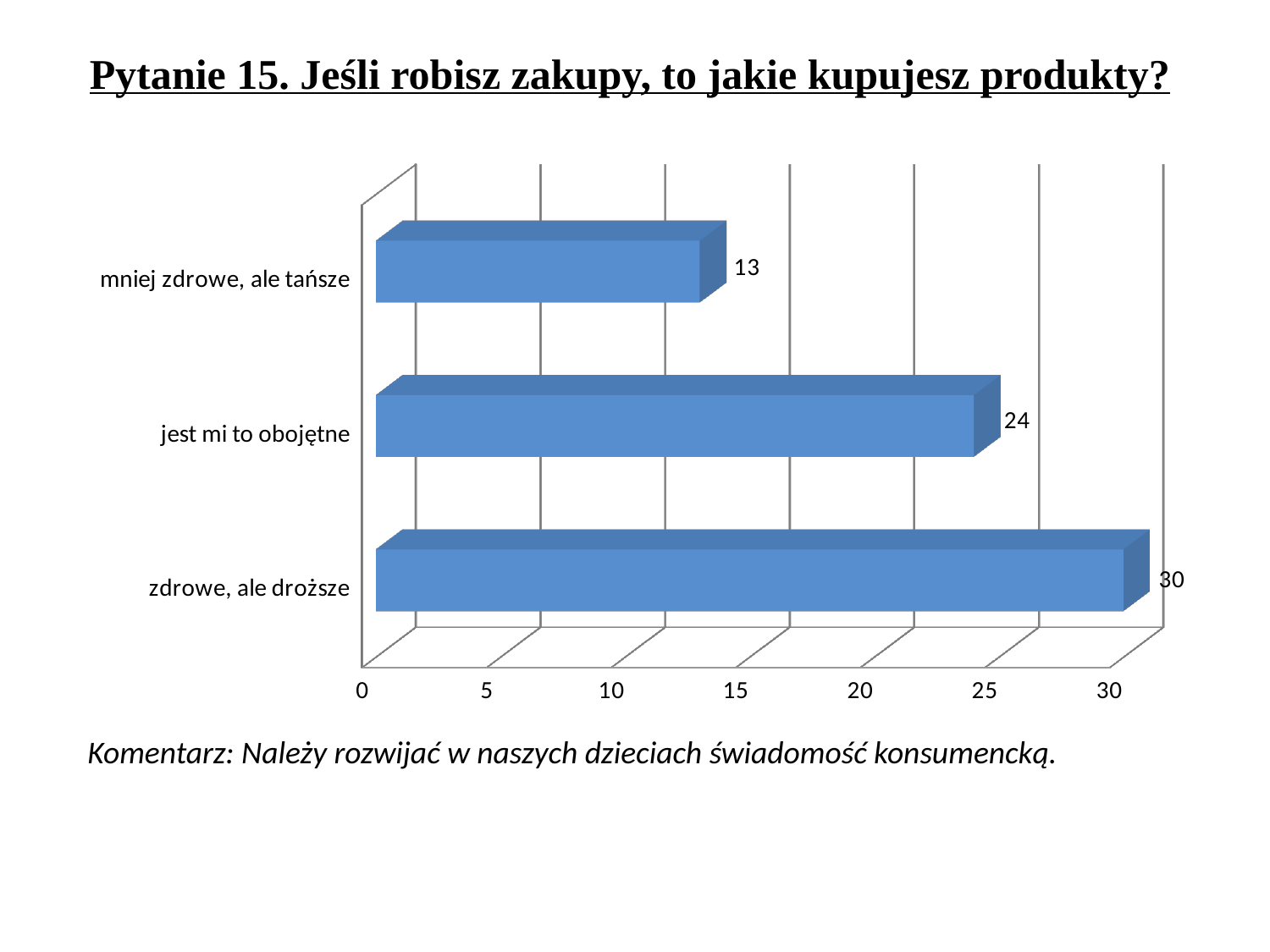
What is the value for "jest mi to obojętne"? 24 What kind of chart is shown on the slide? bar chart What is the difference between the values for "zdrowe, ale droższe" and "mniej zdrowe, ale tańsze"? 17 What is the difference between the values for "jest mi to obojętne" and "mniej zdrowe, ale tańsze"? 11 What is the value for "zdrowe, ale droższe"? 30 Which category has the lowest value? mniej zdrowe, ale tańsze Is the value for "jest mi to obojętne" greater or less than 20? greater Which category has the highest value? zdrowe, ale droższe Which is larger, the value for "jest mi to obojętne" or the value for "mniej zdrowe, ale tańsze"? jest mi to obojętne What is the value for "mniej zdrowe, ale tańsze"? 13 How many categories are shown in the chart? 3 What is the title of the slide above the chart? Pytanie 15. Jeśli robisz zakupy, to jakie kupujesz produkty?